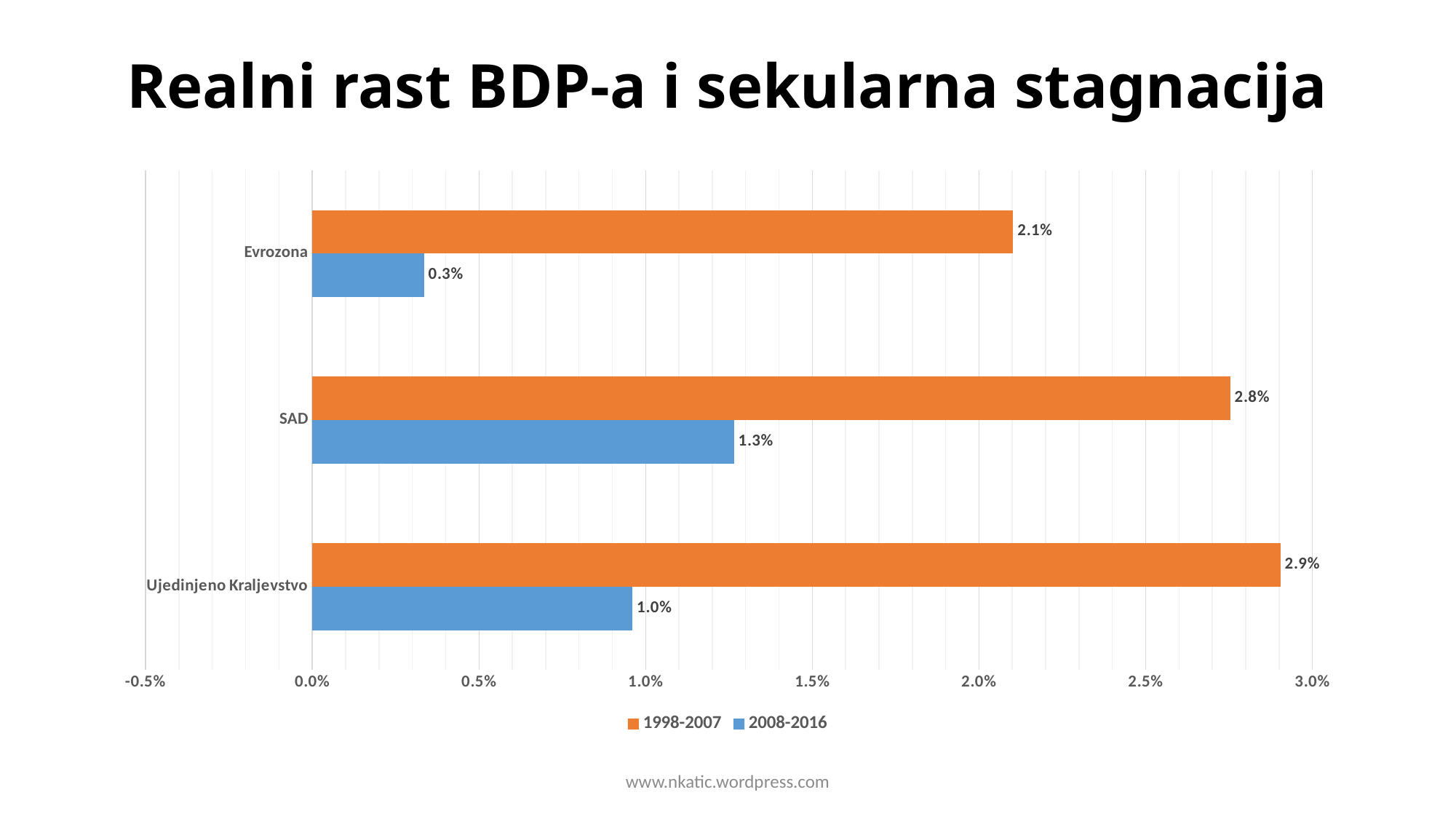
What is the difference between the 1998-2007 and 2008-2016 values for Evrozona? 1.8% Which is larger: the 2008-2016 value for SAD or the 2008-2016 value for Ujedinjeno Kraljevstvo? SAD What is the value for SAD in the 2008-2016 series? 1.3% How many series does the legend list? 2 Which colour represents the 2008-2016 series? Blue Which category has the highest value in the 1998-2007 series? Ujedinjeno Kraljevstvo What is the value for Evrozona in the 1998-2007 series? 2.1% What kind of chart is shown on the slide? Bar chart What is the value for Ujedinjeno Kraljevstvo in the 2008-2016 series? 1.0% Which category has the lowest value in the 2008-2016 series? Evrozona What is the difference between the 1998-2007 and 2008-2016 values for SAD? 1.5% How many categories are shown on the chart? 3